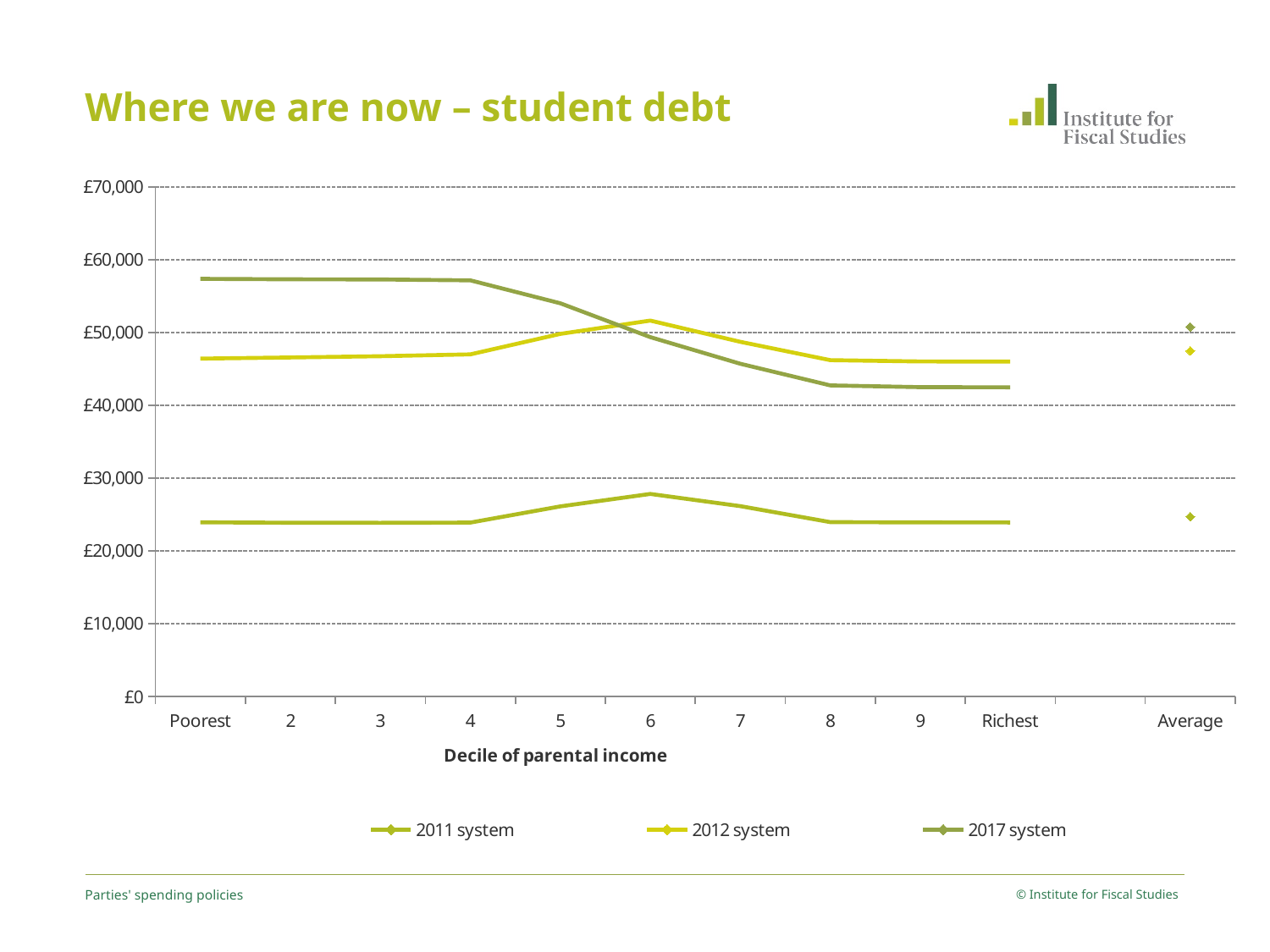
Is the value for the 2011 system at the Poorest decile greater or less than £30,000? less What kind of chart is shown on the slide? Line chart What is the label of the x axis? Decile of parental income How many categories are labelled on the x axis? 11 At the Richest decile, which is larger: the 2012 system or the 2017 system? 2012 system At the Poorest decile, which is larger: the 2017 system or the 2012 system? 2017 system Is the value for the 2017 system at the Poorest decile greater or less than £50,000? greater Is the value for the 2011 system at decile 6 greater or less than £30,000? less Does the 2017 system line rise or fall from the Poorest decile to the Richest decile? Fall Which series has the lowest values across all deciles? 2011 system How many series does the legend list? 3